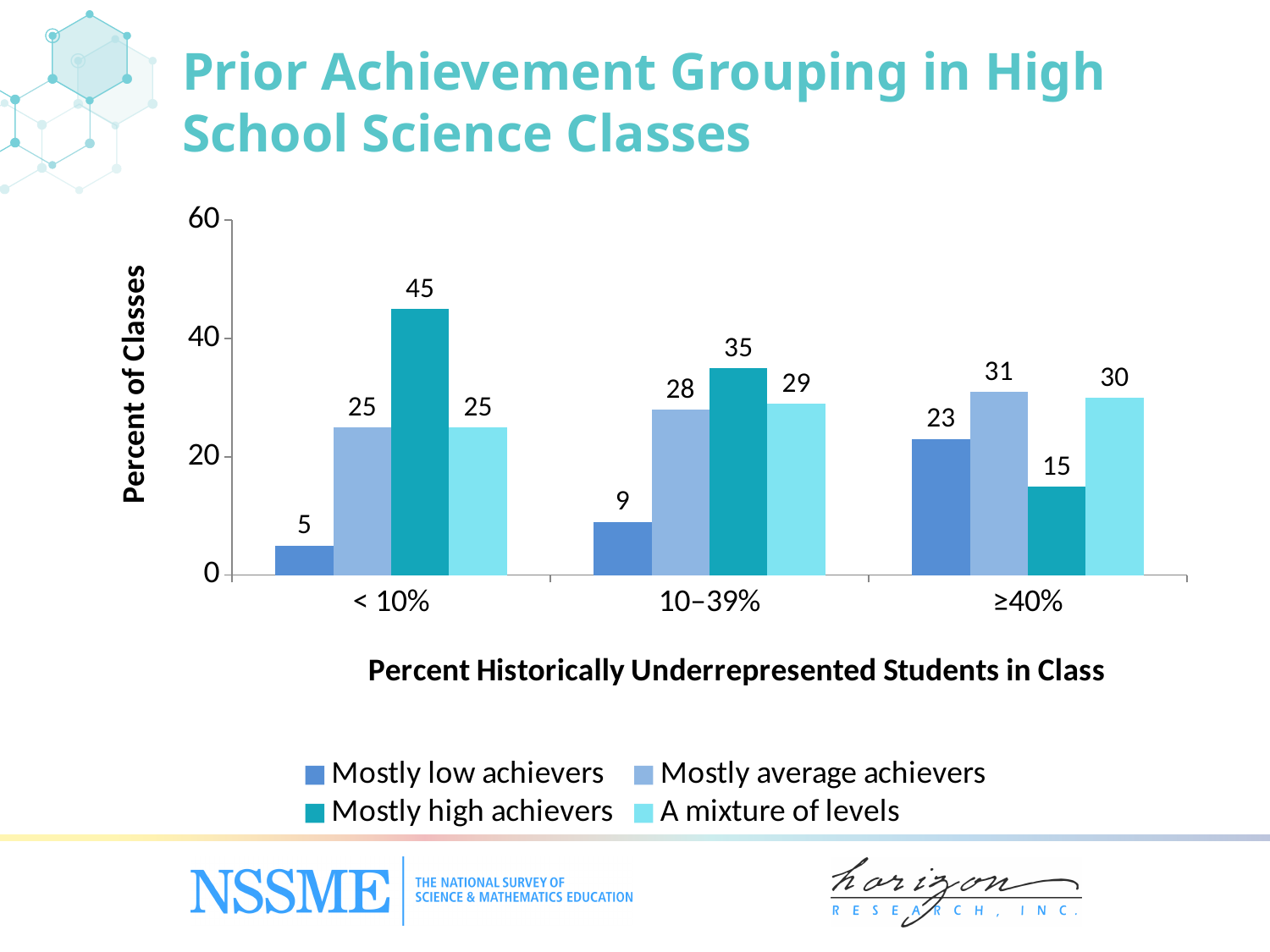
Do the values for 'Mostly low achievers' rise or fall from left to right along the x axis? Rise What is the value for 'Mostly low achievers' in the 10–39% category? 9 What percent of classes with < 10% historically underrepresented students are composed of mostly high achievers? 45 Which category has the highest value for 'Mostly low achievers'? ≥40% How many series does the legend list? 4 Which category has the lowest value for 'Mostly high achievers'? ≥40% How many categories are shown on the x axis? 3 What is the difference between the 'Mostly high achievers' values for the < 10% and ≥40% categories? 30 What is the value for 'A mixture of levels' in the ≥40% category? 30 What kind of chart is shown on the slide? Bar chart Is the value for 'Mostly high achievers' in the < 10% category greater or less than 40? greater In the ≥40% category, which is larger: 'Mostly average achievers' or 'Mostly high achievers'? Mostly average achievers